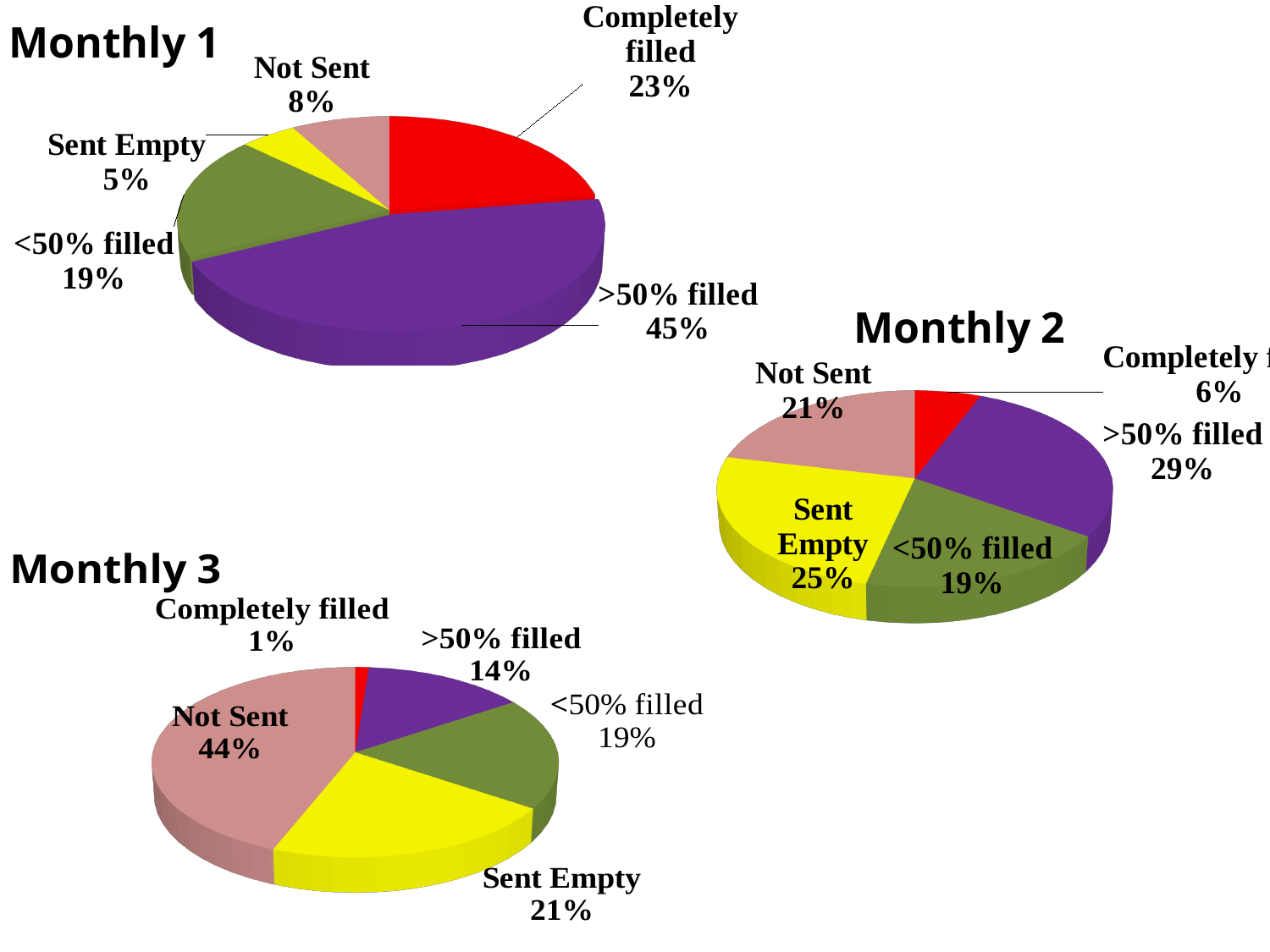
In the Monthly 1 chart, which category has the smallest share? Sent Empty In the Monthly 2 chart, which is larger, 'Not Sent' or '<50% filled'? Not Sent In the Monthly 1 chart, what share is '>50% filled'? 45% What type of chart is the Monthly 1 chart? Pie chart In the Monthly 2 chart, what colour is the 'Sent Empty' slice? Yellow In the Monthly 3 chart, what share is 'Not Sent'? 44% In the Monthly 3 chart, what is the difference between 'Sent Empty' and '>50% filled'? 7% In the Monthly 1 chart, what is the difference between 'Completely filled' and 'Not Sent'? 15% How many slices does the Monthly 3 chart have? 5 In the Monthly 2 chart, which category has the largest share? >50% filled In the Monthly 3 chart, which category has the smallest share? Completely filled In the Monthly 2 chart, what share is 'Sent Empty'? 25%